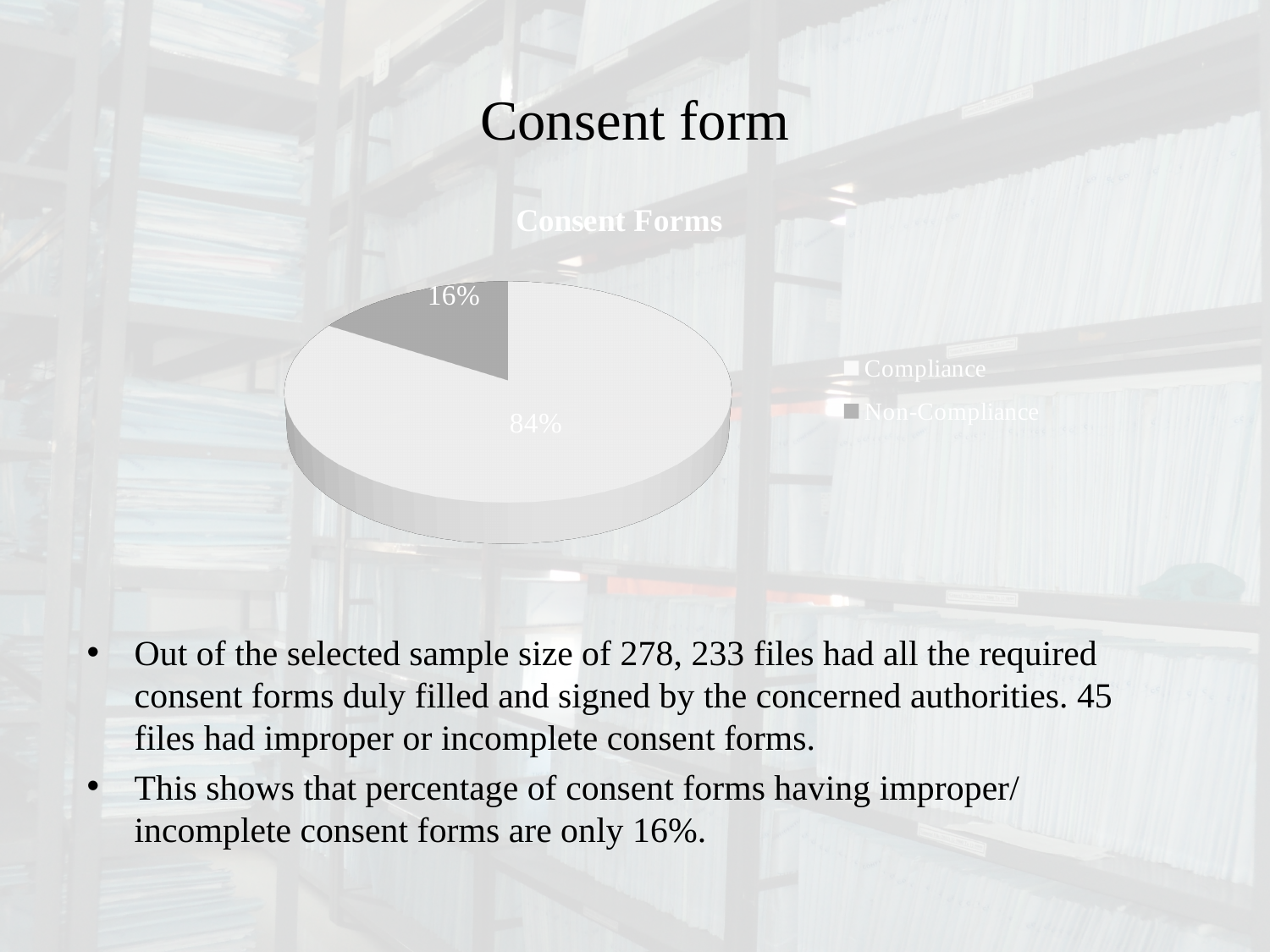
How many slices does the pie chart have? 2 What percentage of the pie is labelled for Non-Compliance? 16% What is the title of the chart? Consent Forms Which slice of the pie is the smallest? Non-Compliance What share of the pie does the Non-Compliance slice represent? 16% What kind of chart is shown on the slide? pie chart What percentage of the pie is labelled for Compliance? 84% How many entries does the legend list? 2 Which is larger, the Compliance slice or the Non-Compliance slice? Compliance What is the difference in percentage points between the Compliance and Non-Compliance slices? 68 Which slice of the pie is the largest? Compliance